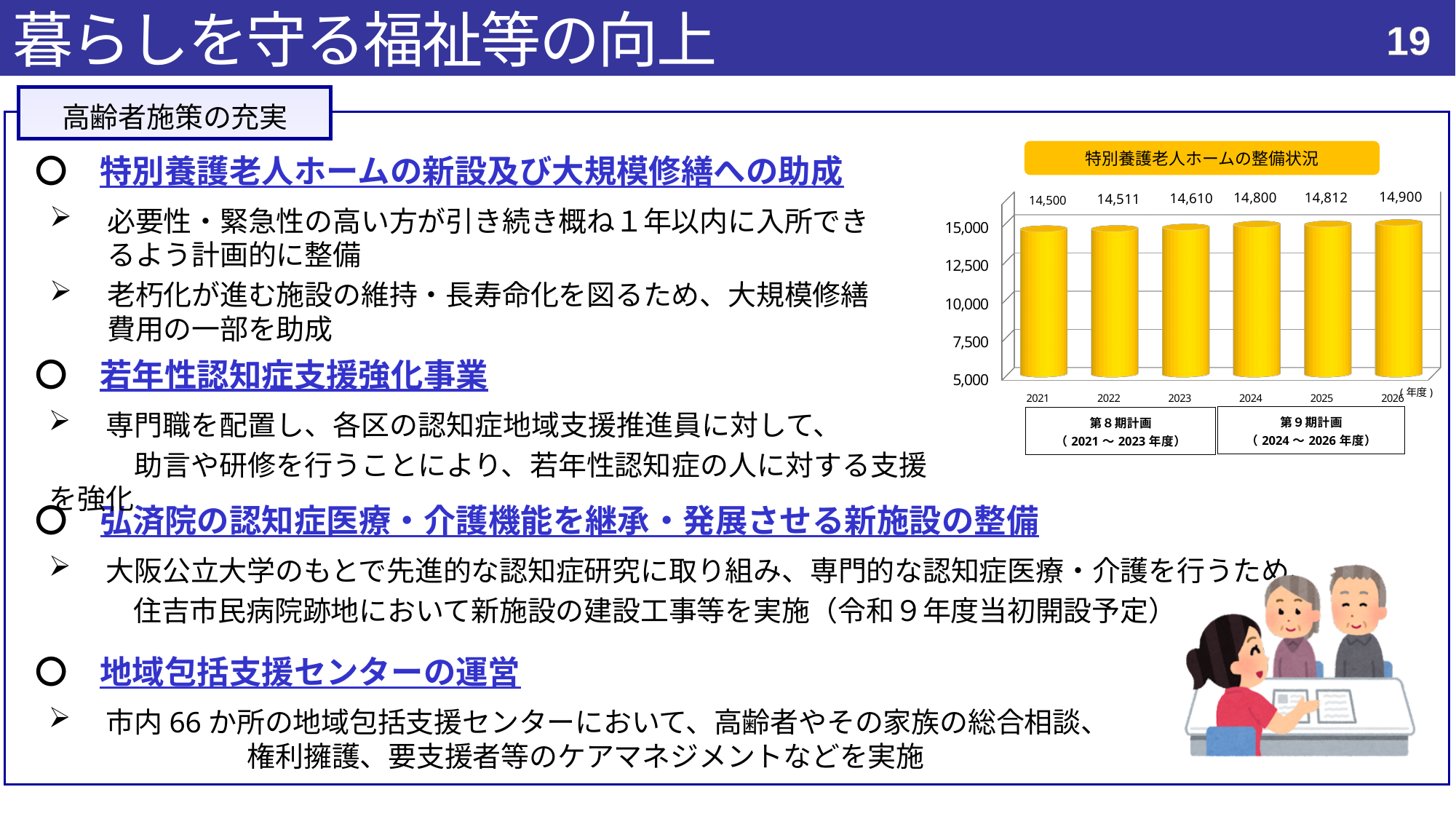
What is the value for 2025 in the 特別養護老人ホームの整備状況 chart? 14,812 Which year has the highest value in the 特別養護老人ホームの整備状況 chart? 2026 What is the difference between the 2024 and 2023 values in the 特別養護老人ホームの整備状況 chart? 190 What is the difference between the 2026 and 2021 values in the 特別養護老人ホームの整備状況 chart? 400 Which plan period covers 2024 to 2026 according to the labels under the 特別養護老人ホームの整備状況 chart? 第９期計画 Which year has the lowest value in the 特別養護老人ホームの整備状況 chart? 2021 Do the values in the 特別養護老人ホームの整備状況 chart rise or fall from 2021 to 2026? Rise What is the value for 2021 in the 特別養護老人ホームの整備状況 chart? 14,500 What kind of chart is the 特別養護老人ホームの整備状況 chart? Bar chart What is the value for 2026 in the 特別養護老人ホームの整備状況 chart? 14,900 What is the value for 2023 in the 特別養護老人ホームの整備状況 chart? 14,610 How many years are plotted in the 特別養護老人ホームの整備状況 chart? 6